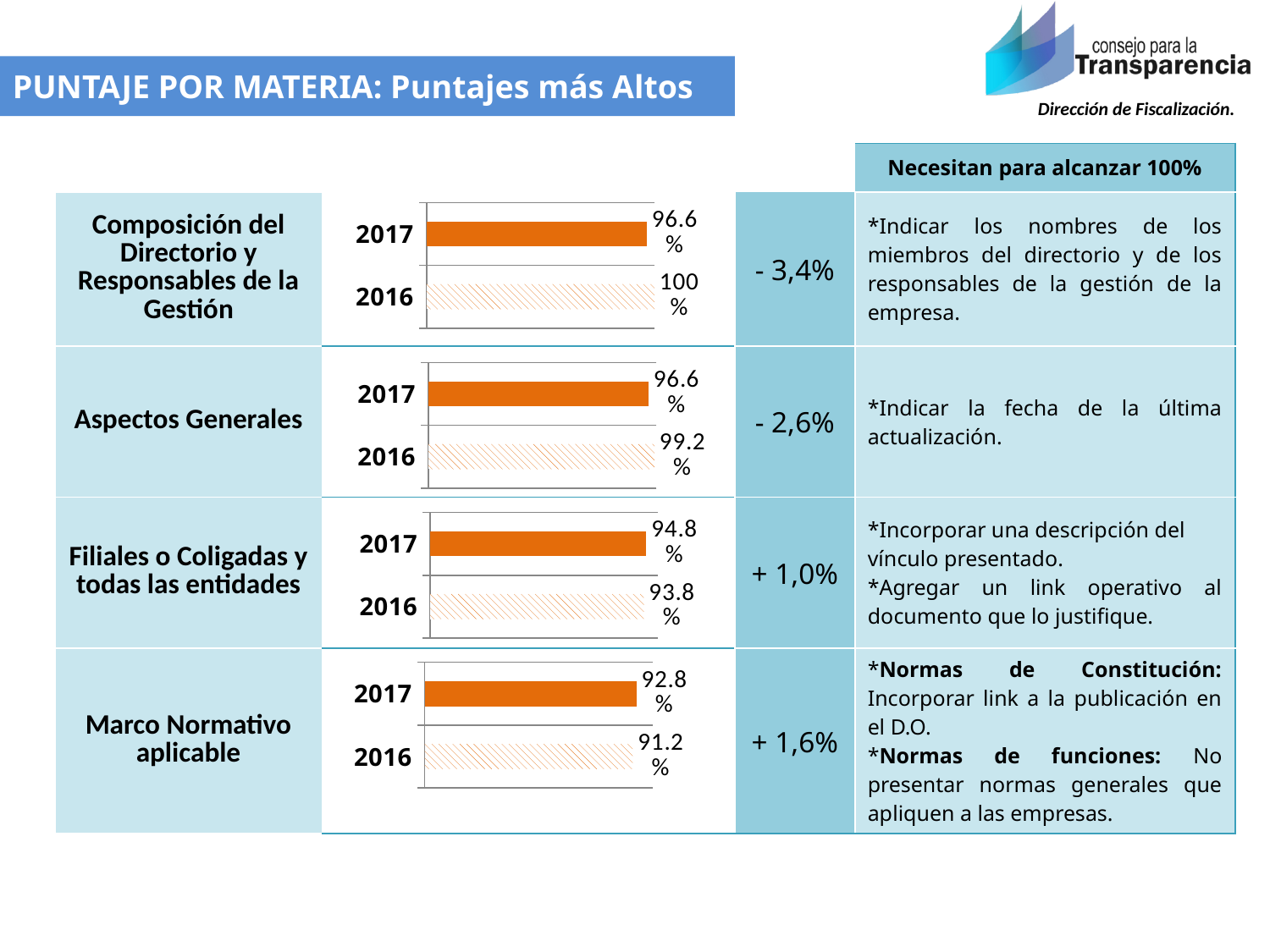
In the chart for Marco Normativo aplicable, what is the value for 2016? 91.2% In the chart for Marco Normativo aplicable, which year has the higher value? 2017 In the chart for Aspectos Generales, which year has the lower value? 2017 What type of chart is used for Aspectos Generales? Bar chart How many bars are shown in the chart for Marco Normativo aplicable? 2 In the chart for Filiales o Coligadas y todas las entidades, what is the value for 2017? 94.8% In the chart for Composición del Directorio y Responsables de la Gestión, what is the value for 2017? 96.6% In the chart for Aspectos Generales, what is the value for 2016? 99.2% In the chart for Composición del Directorio y Responsables de la Gestión, what is the difference between the 2016 and 2017 values? 3.4% How many small charts are shown on the slide? 4 In the chart for Filiales o Coligadas y todas las entidades, what is the difference between the 2017 and 2016 values? 1.0% In the chart for Composición del Directorio y Responsables de la Gestión, what is the value for 2016? 100%